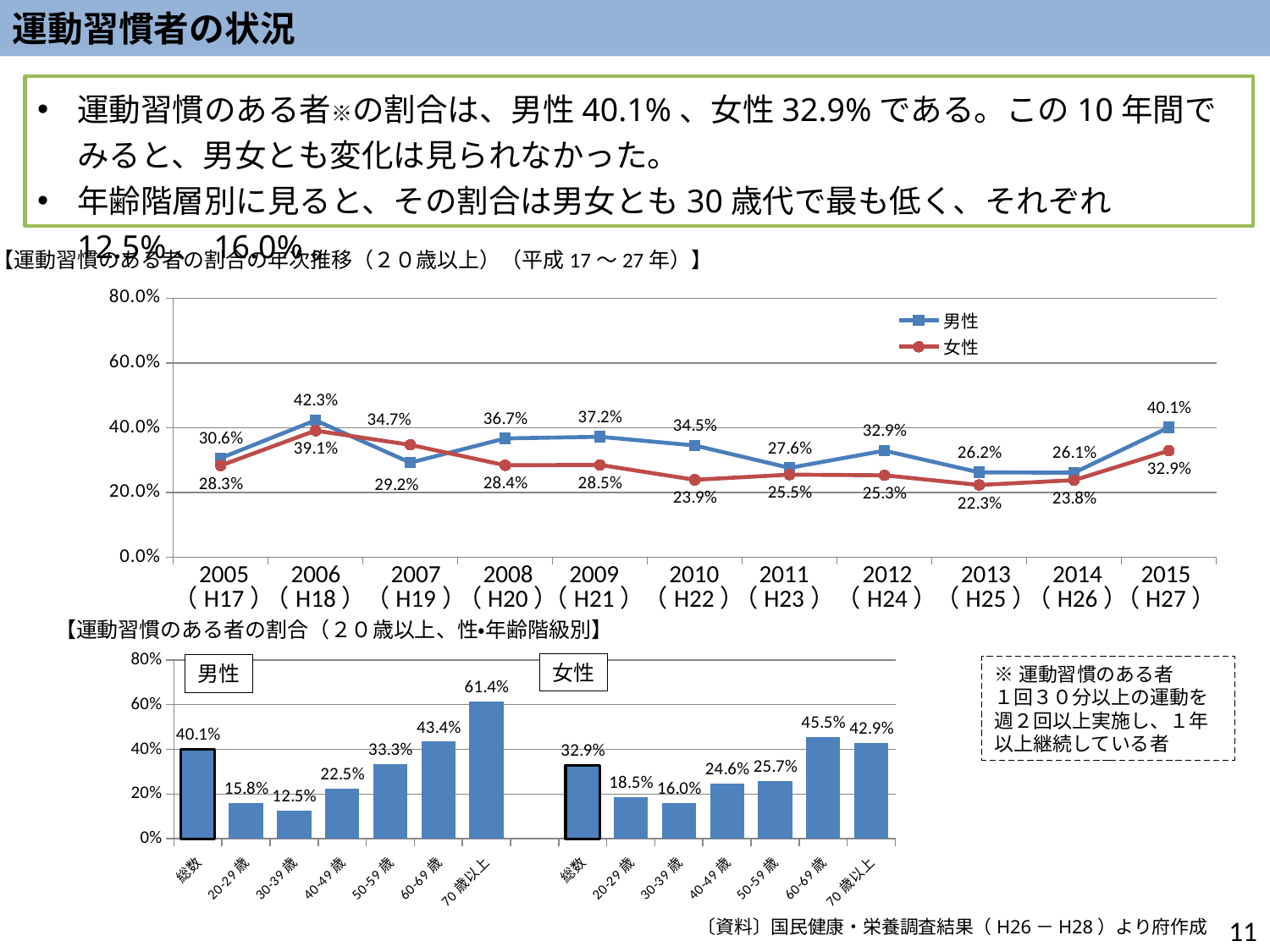
How many series does the legend of the top line chart list? 2 In the top line chart, in which year is the 男性 value highest? 2006 (H18) In the top line chart, in which year is the 女性 value lowest? 2013 (H25) In the top line chart (運動習慣のある者の割合の年次推移), what is the value for 男性 in 2015 (H27)? 40.1% In the top line chart, what is the value for 女性 in 2013 (H25)? 22.3% How many years are plotted on the x axis of the top line chart? 11 In the bottom bar chart, which age group has the lowest value for 女性? 30-39歳 What kind of chart is the bottom chart (運動習慣のある者の割合 性・年齢階級別)? bar chart In the bottom bar chart, which is larger, 男性 60-69歳 or 女性 60-69歳? 女性 60-69歳 In the bottom bar chart, what is the value for 男性 aged 70歳以上? 61.4% In the top line chart, which series has the larger value in 2007 (H19), 男性 or 女性? 女性 In the top line chart, what is the difference between the 男性 and 女性 values in 2015 (H27)? 7.2%